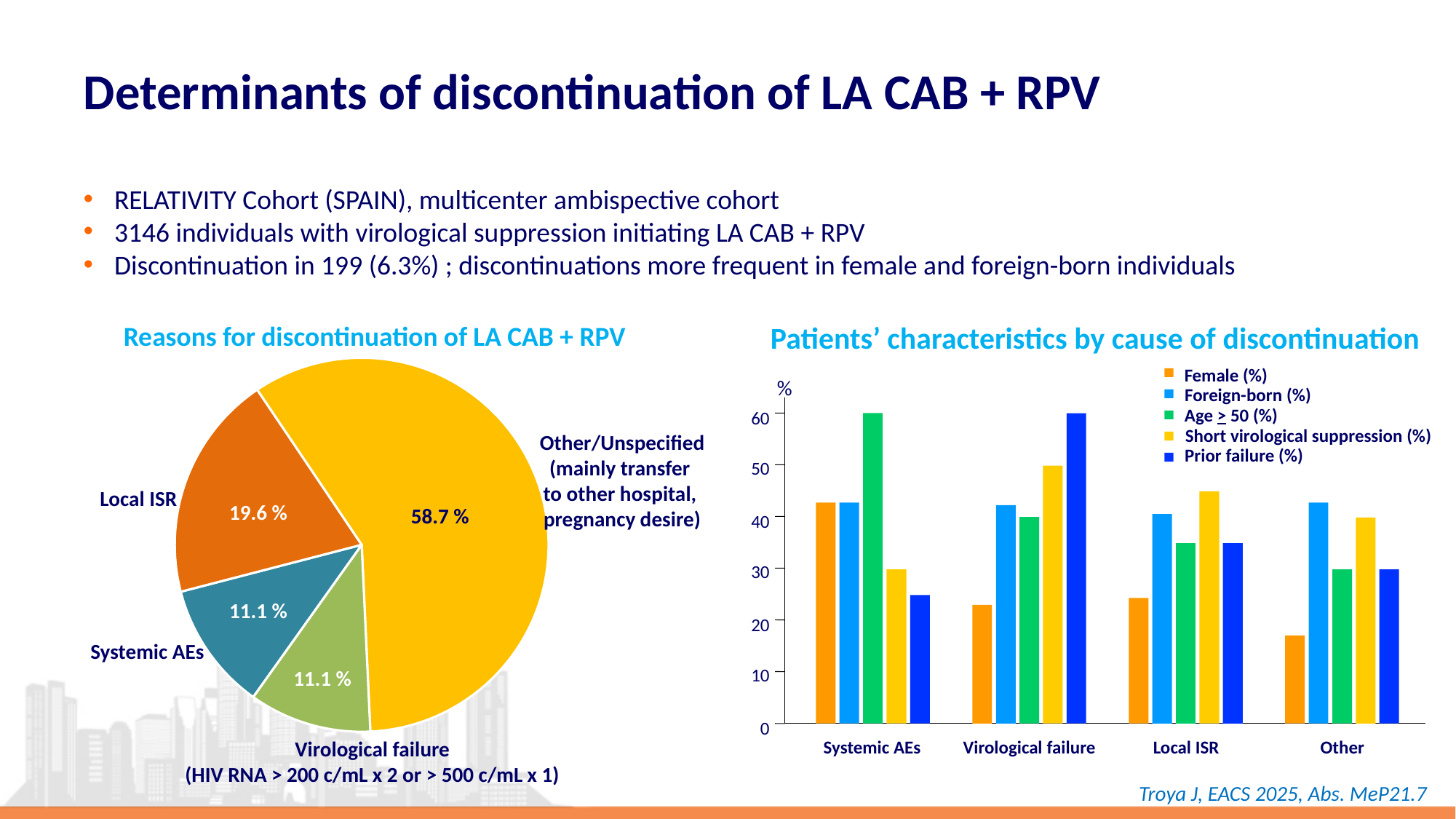
In the pie chart 'Reasons for discontinuation of LA CAB + RPV', what share is labelled for Local ISR? 19.6 % In the pie chart 'Reasons for discontinuation of LA CAB + RPV', which is larger: the Local ISR slice or the Systemic AEs slice? Local ISR In the chart 'Patients' characteristics by cause of discontinuation', is the Female (%) value for Other greater or less than 20? less In the chart 'Patients' characteristics by cause of discontinuation', is the Age ≥ 50 (%) value for Systemic AEs greater or less than 50? greater In the chart 'Patients' characteristics by cause of discontinuation', which series has the highest value for Virological failure? Prior failure (%) In the chart 'Patients' characteristics by cause of discontinuation', how many causes of discontinuation are shown on the x axis? 4 In the pie chart 'Reasons for discontinuation of LA CAB + RPV', what is the difference between the Other/Unspecified share and the Local ISR share? 39.1 % In the chart 'Patients' characteristics by cause of discontinuation', how many series does the legend list? 5 In the pie chart 'Reasons for discontinuation of LA CAB + RPV', which reason has the largest slice? Other/Unspecified In the pie chart 'Reasons for discontinuation of LA CAB + RPV', what share is labelled for Other/Unspecified? 58.7 % In the pie chart 'Reasons for discontinuation of LA CAB + RPV', how many slices are there? 4 What kind of chart is 'Reasons for discontinuation of LA CAB + RPV'? Pie chart